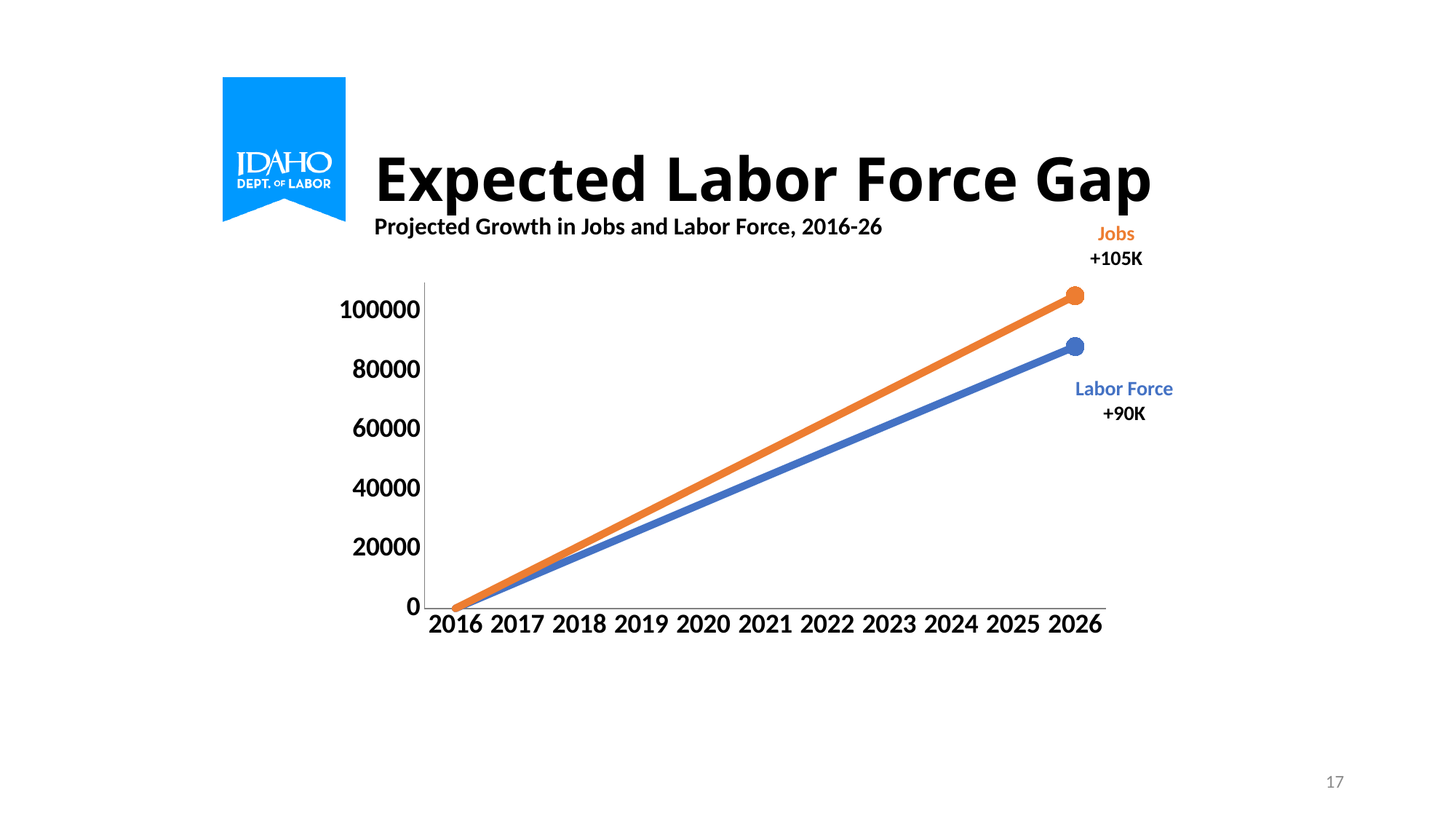
Is the Jobs value in 2026 greater or less than 100000? greater What is the projected growth in Labor Force by 2026 according to the label on the chart? +90K What colour is the line for the Labor Force series? blue What kind of chart is shown on the slide? line chart What is the subtitle printed above the chart? Projected Growth in Jobs and Labor Force, 2016-26 What is the difference between the labelled 2026 growth for Jobs and for Labor Force? 15K How many data series are plotted on the chart? 2 How many years are labelled on the x axis? 11 Is the Labor Force value in 2026 greater or less than 80000? greater Which series ends higher in 2026, Jobs or Labor Force? Jobs What is the projected growth in Jobs by 2026 according to the label on the chart? +105K Do the values for both series rise or fall from 2016 to 2026? rise